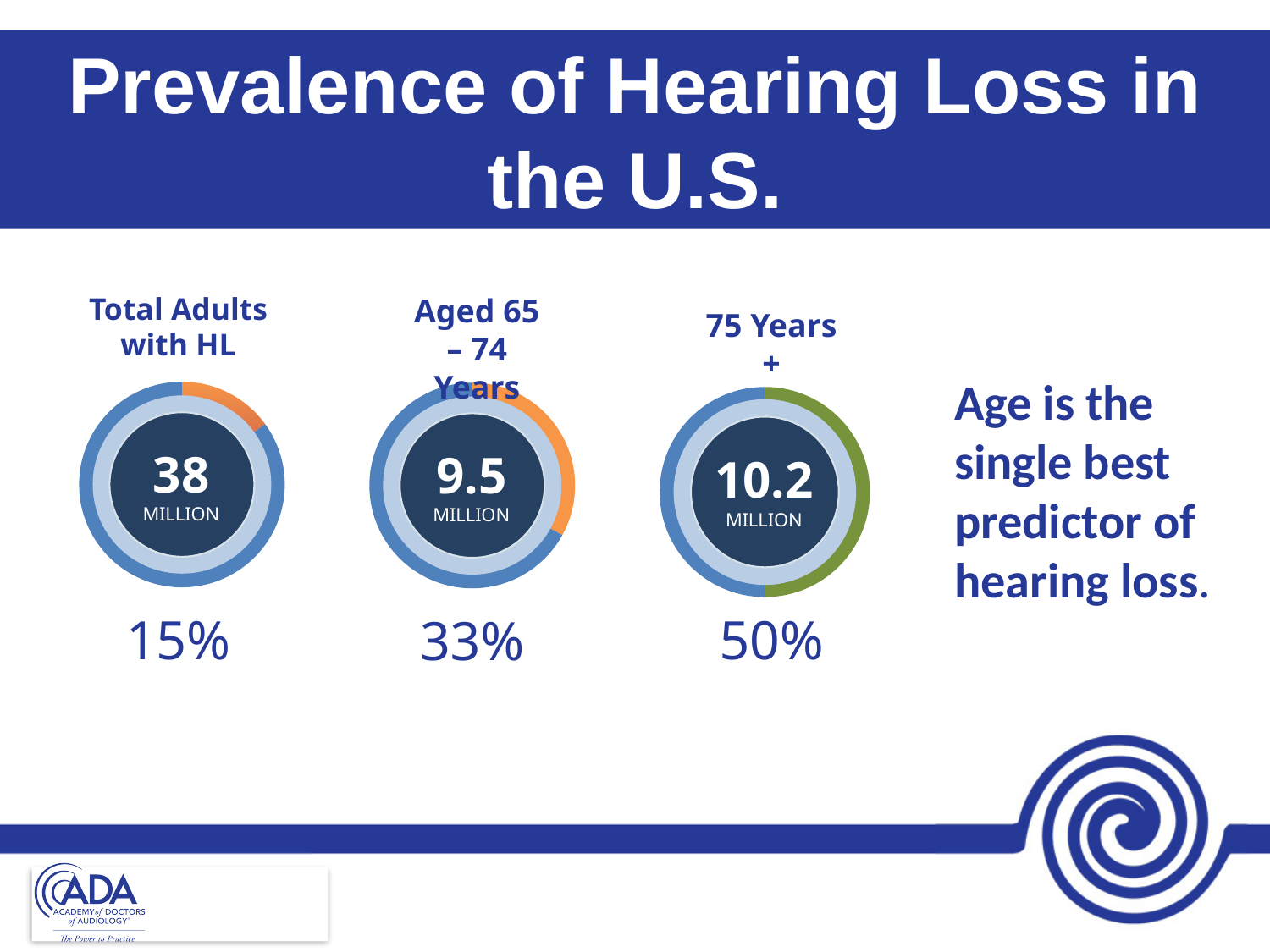
What number is printed in the centre of the 'Total Adults with HL' donut chart? 38 MILLION What percentage is shown below the '75 Years +' donut chart? 50% What is the difference in percentage between the '75 Years +' chart and the 'Aged 65 – 74 Years' chart? 17% What number is printed in the centre of the '75 Years +' donut chart? 10.2 MILLION What colour is the filled segment of the '75 Years +' donut chart? Green How many donut charts are shown on the slide? 3 Which of the three donut charts shows the lowest percentage? Total Adults with HL Which of the three donut charts shows the highest percentage? 75 Years + What number is printed in the centre of the 'Aged 65 – 74 Years' donut chart? 9.5 MILLION What percentage is shown below the 'Total Adults with HL' donut chart? 15% Which is larger: the percentage for 'Aged 65 – 74 Years' or the percentage for 'Total Adults with HL'? Aged 65 – 74 Years What percentage is shown below the 'Aged 65 – 74 Years' donut chart? 33%